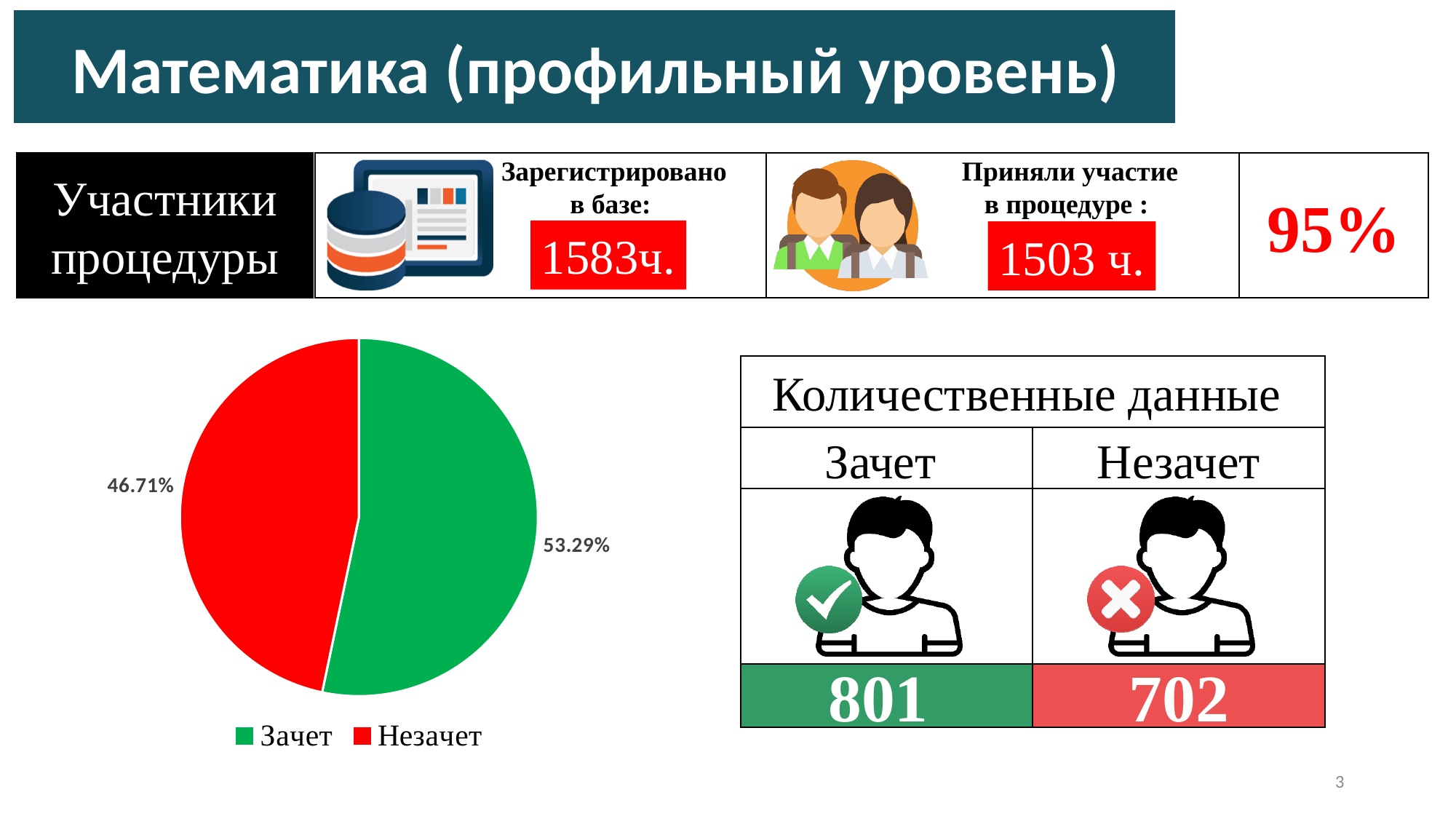
Which slice of the pie chart is the smallest? Незачет Which is larger in the pie chart, Зачет or Незачет? Зачет How many slices does the pie chart have? 2 Which slice of the pie chart is the largest? Зачет How many entries does the pie chart legend list? 2 What kind of chart is shown on the slide? pie chart What colour is the Незачет slice in the pie chart? red What share of the pie does Зачет represent? 53.29% What is the difference in percentage points between the Зачет and Незачет slices? 6.58 What colour is the Зачет slice in the pie chart? green What share of the pie does Незачет represent? 46.71%